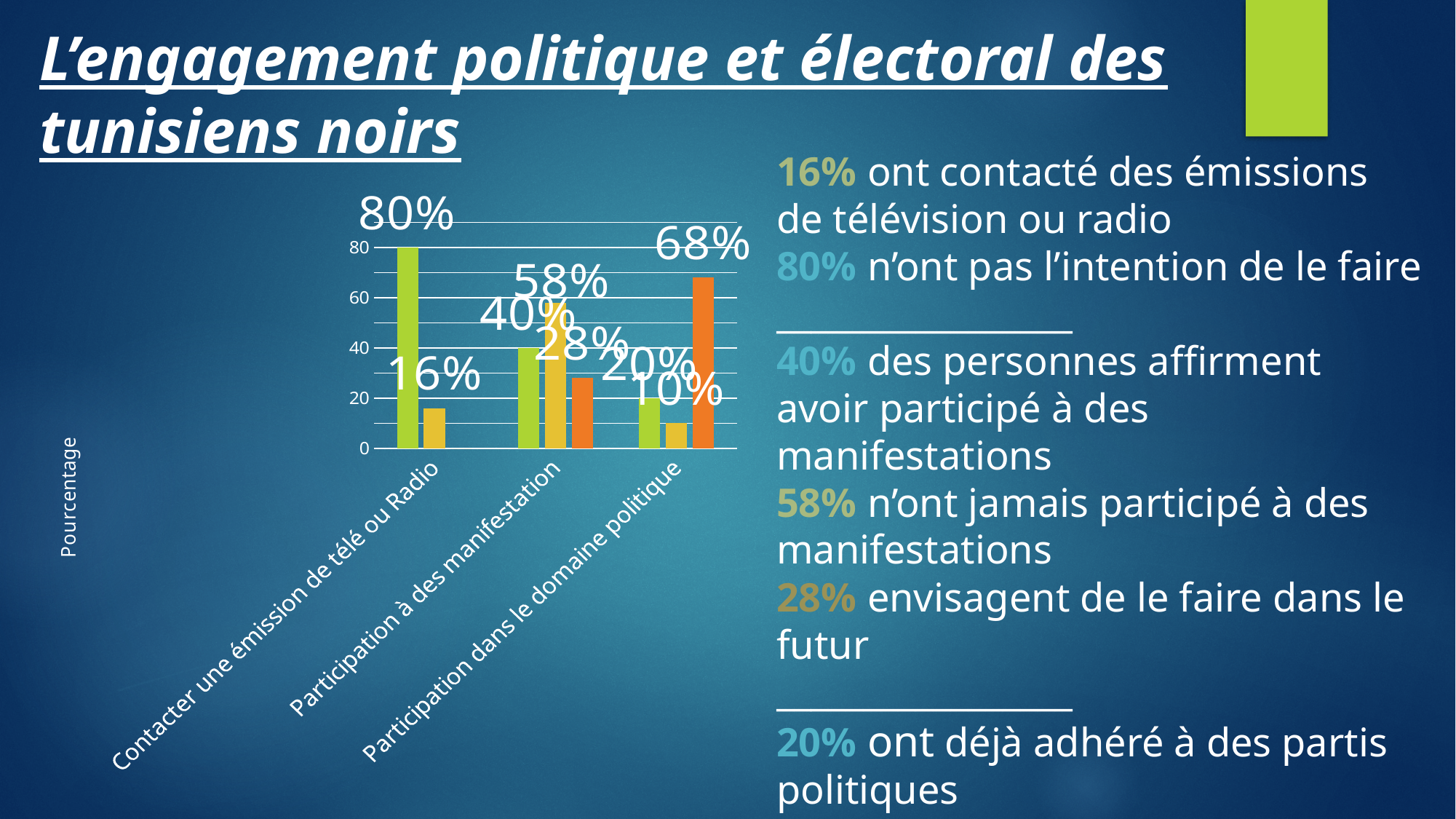
How many categories are shown on the x axis of the chart? 3 What is the value of the yellow bar for "Participation à des manifestation"? 58% Which category contains the tallest bar in the chart? Contacter une émission de télé ou Radio What kind of chart is shown on the slide? Bar chart What is the value of the orange bar for "Participation dans le domaine politique"? 68% What is the value of the lowest bar in the chart? 10% For "Participation à des manifestation", which is larger: the green bar or the yellow bar? The yellow bar What is the difference between the green bar and the yellow bar for "Contacter une émission de télé ou Radio"? 64 percentage points Is the value of the orange bar for "Participation dans le domaine politique" greater or less than 60? greater What is the value of the green bar for "Contacter une émission de télé ou Radio"? 80% What is the title of the vertical axis of the chart? Pourcentage What is the value of the yellow bar for "Contacter une émission de télé ou Radio"? 16%